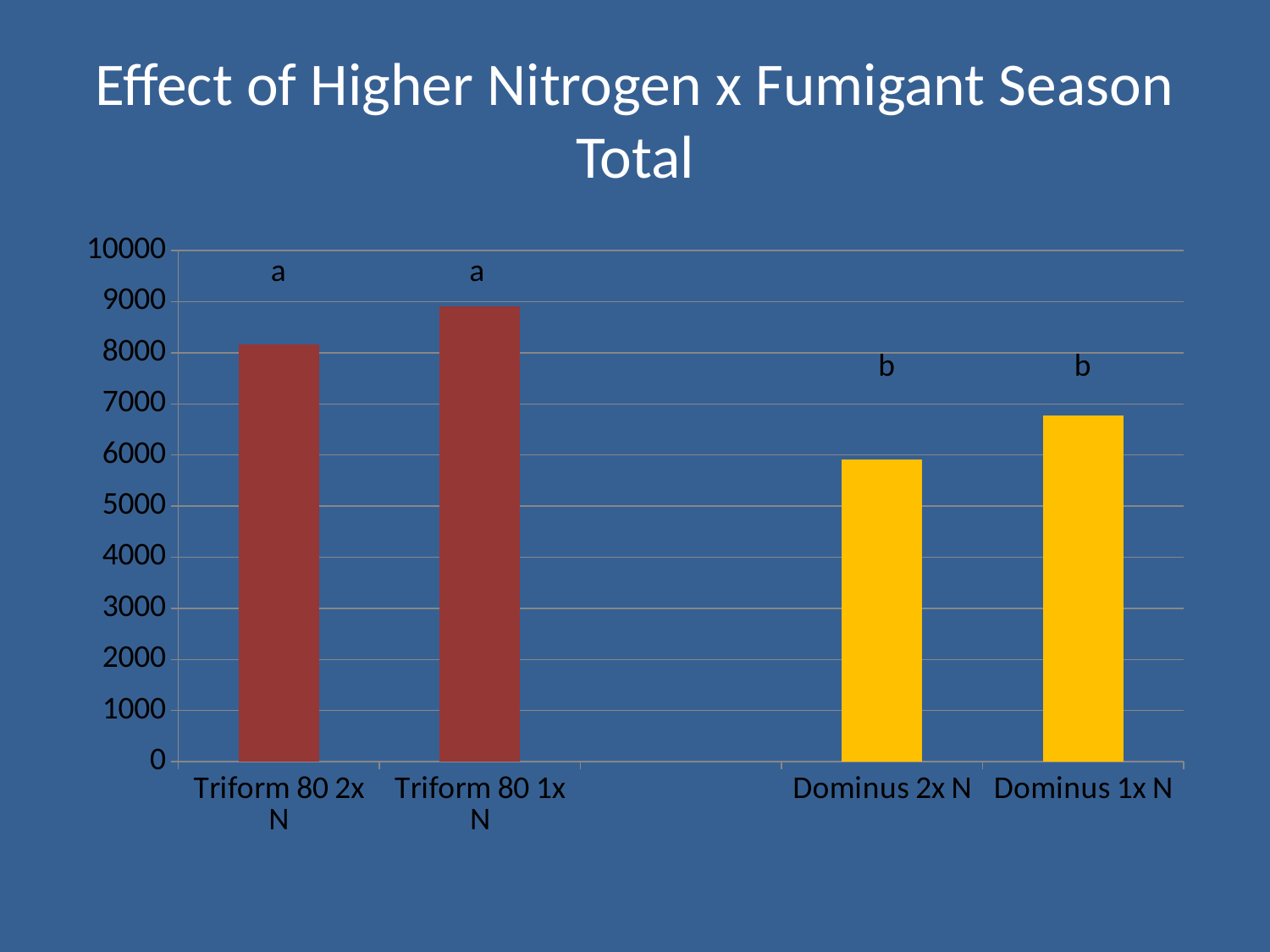
Which is larger, the value for Dominus 1x N or the value for Dominus 2x N? Dominus 1x N Is the value for Dominus 1x N greater or less than 7000? less Is the value for Triform 80 2x N greater or less than 8000? greater How many bars (categories) are plotted in the chart? 4 What letter is printed above the two Dominus bars? b Which category has the lowest bar? Dominus 2x N Is the value for Triform 80 1x N greater or less than 9000? less What is the title of the chart on the slide? Effect of Higher Nitrogen x Fumigant Season Total Which is larger, the value for Triform 80 2x N or the value for Dominus 1x N? Triform 80 2x N Which category has the highest bar? Triform 80 1x N What kind of chart is shown on the slide? bar chart